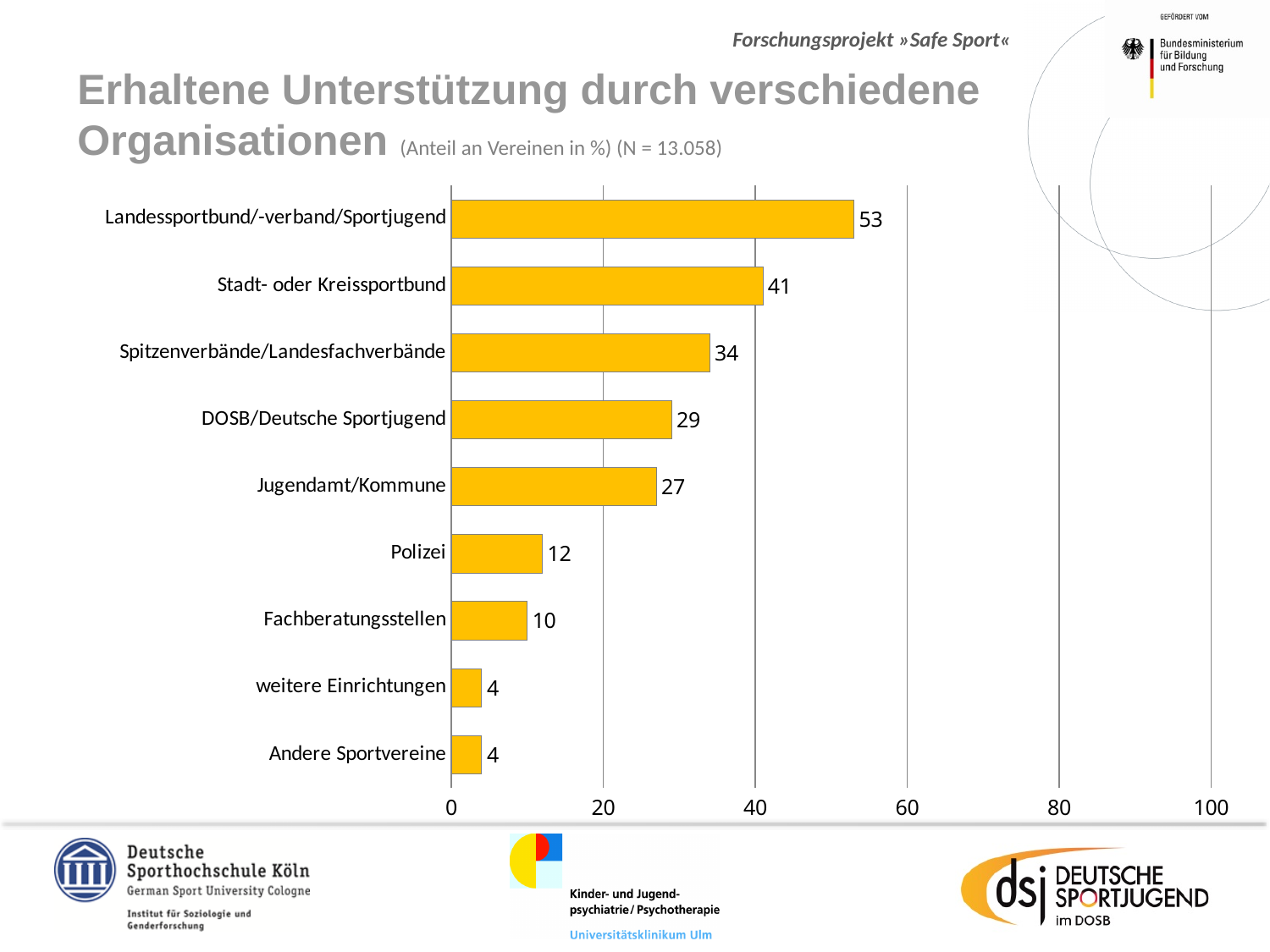
How many categories are shown in the chart? 9 What is the difference between the values for Landessportbund/-verband/Sportjugend and DOSB/Deutsche Sportjugend? 24 What is the difference between the values for Stadt- oder Kreissportbund and Spitzenverbände/Landesfachverbände? 7 What kind of chart is shown on the slide? bar chart Which is larger, the value for Polizei or the value for Fachberatungsstellen? Polizei What is the value for Polizei? 12 What is the highest value shown on the x axis? 100 Which category has the highest value? Landessportbund/-verband/Sportjugend What is the value for Jugendamt/Kommune? 27 Is the value for Stadt- oder Kreissportbund greater or less than 40? greater What is the sample size (N) stated in the chart subtitle? 13.058 What is the value for Landessportbund/-verband/Sportjugend? 53